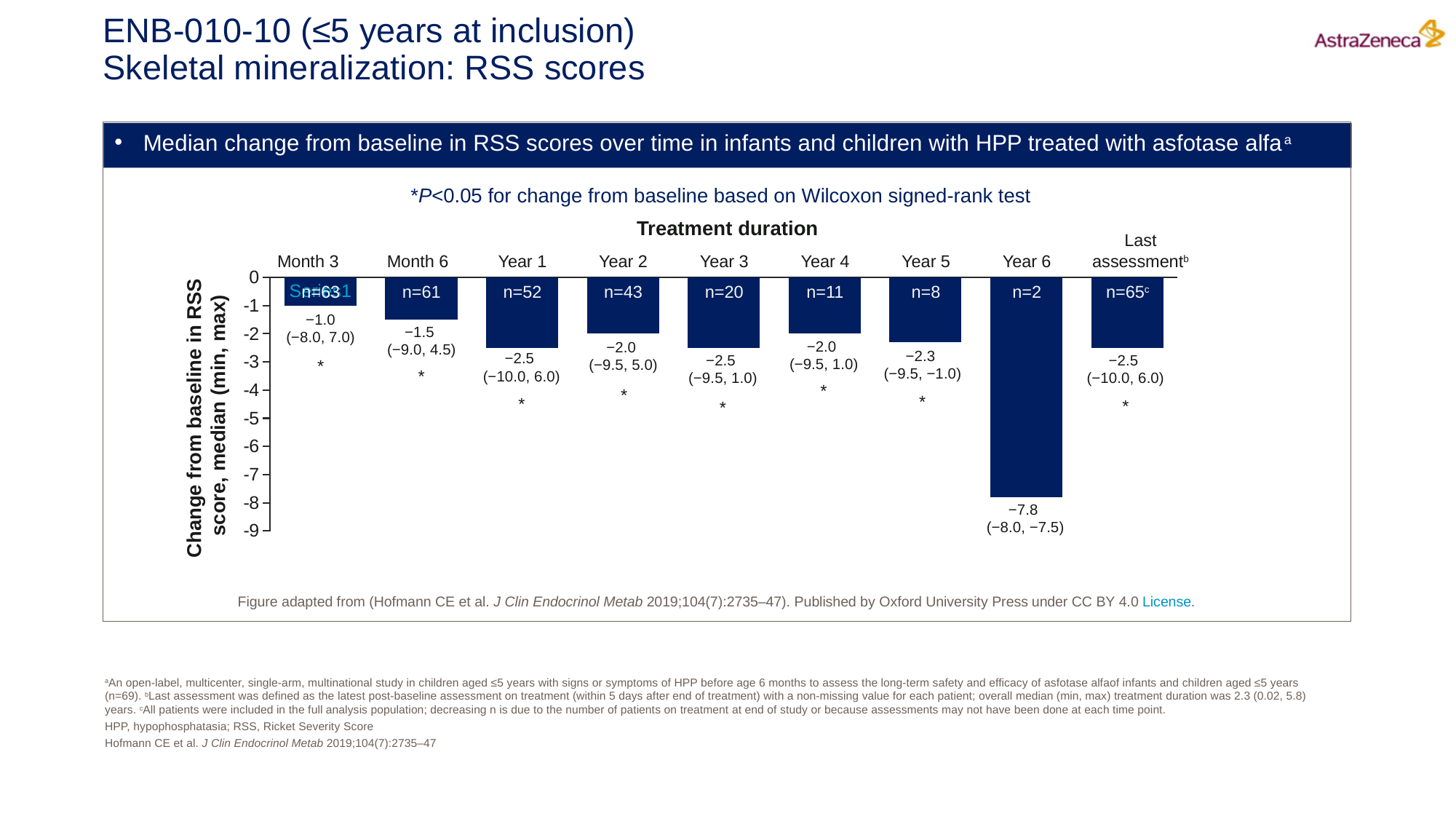
What is the median change from baseline in RSS score at Month 3? −1.0 How many patients (n) are included at Year 2? n=43 How many treatment duration time points are plotted on the chart? 9 What is the difference between the median change at Year 6 and at Year 5? 5.5 Which treatment duration time point has the largest (most negative) median change from baseline? Year 6 What is the median change from baseline in RSS score at Last assessment? −2.5 What is the (min, max) range shown for Year 5? (−9.5, −1.0) What is the median change from baseline in RSS score at Year 6? −7.8 What kind of chart is used to show the median change from baseline in RSS scores? Bar chart Which treatment duration time point has the smallest median change from baseline? Month 3 What is the label of the y axis of the chart? Change from baseline in RSS score, median (min, max) Is the median change from baseline at Year 1 more negative than at Year 2? Yes